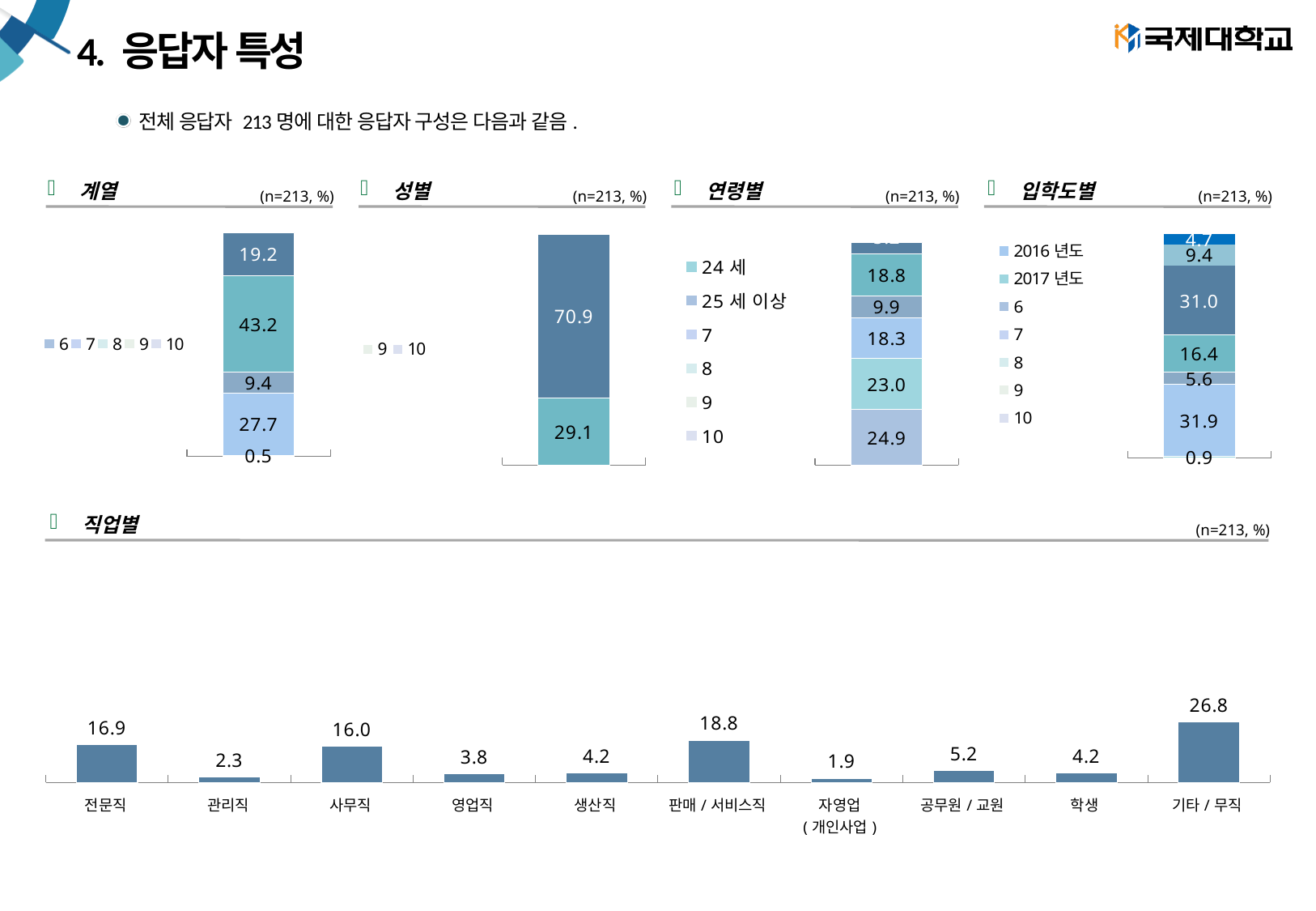
In the 직업별 chart, which category has the lowest value? 자영업 (개인사업) How many categories are shown in the 직업별 chart? 10 In the 직업별 chart, what is the value for 판매 / 서비스직? 18.8 In the 계열 chart, what is the value of the largest segment of the stacked bar? 43.2 In the 직업별 chart, what is the difference between 기타 / 무직 and 판매 / 서비스직? 8.0 What kind of chart is the 직업별 chart? bar chart What sample size (n) is shown next to the 직업별 chart title? n=213 In the 성별 chart, what is the value of the larger segment? 70.9 In the 직업별 chart, which is larger, 전문직 or 사무직? 전문직 In the 성별 chart, what is the difference between the two segments? 41.8 In the 직업별 chart, what is the value for 전문직? 16.9 In the 직업별 chart, which category has the highest value? 기타 / 무직